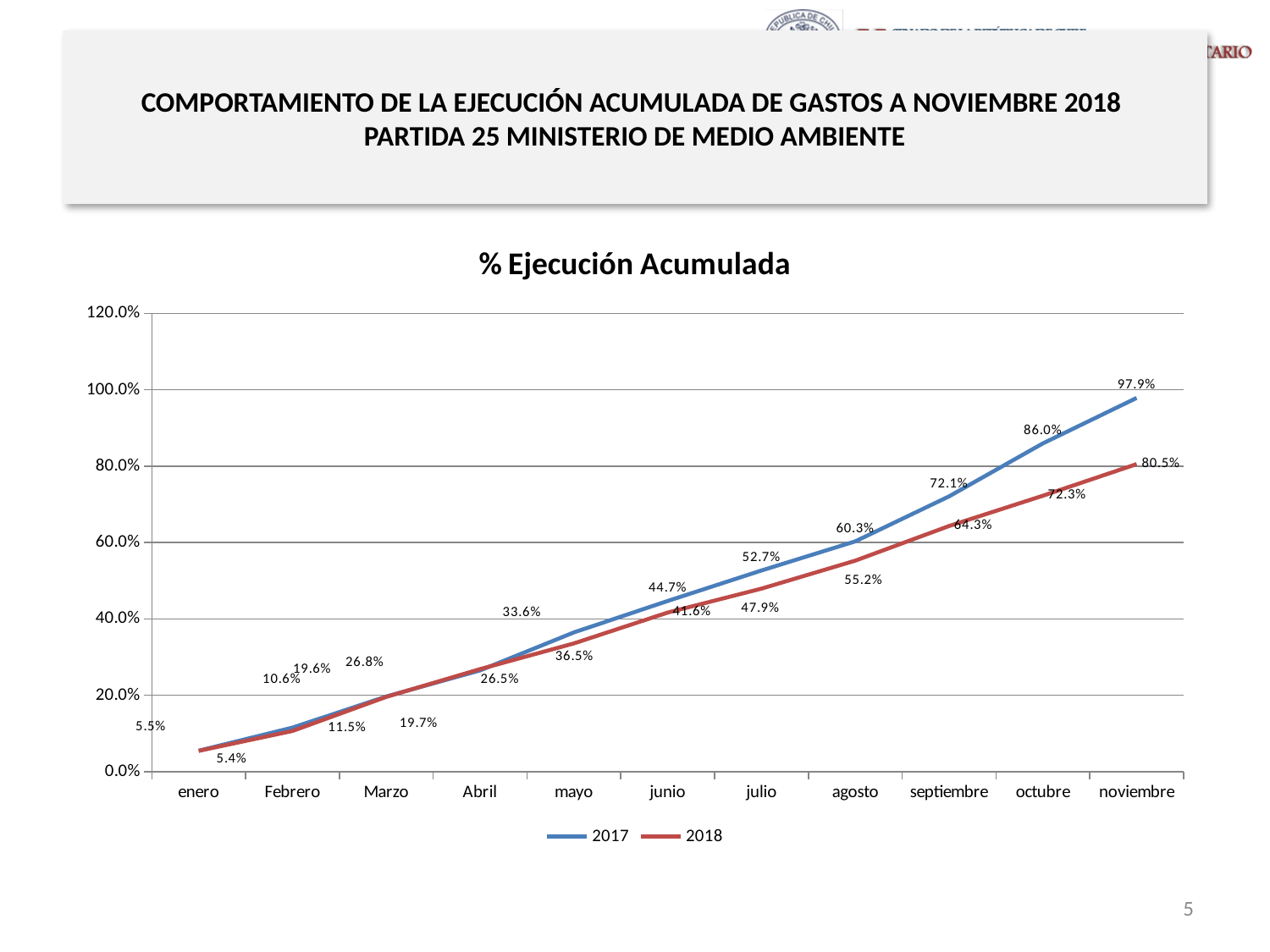
What is the value for 2018 in enero? 5.4% What is the value for 2017 in octubre? 86.0% What is the value for 2017 in noviembre? 97.9% What kind of chart is shown on the slide? Line chart In noviembre, which series has the higher value, 2017 or 2018? 2017 How many series does the legend list? 2 Do the values for 2018 rise or fall from enero to noviembre? Rise What is the value for 2017 in enero? 5.5% What is the difference between the 2017 and 2018 values in noviembre? 17.4 percentage points What is the value for 2018 in noviembre? 80.5% How many months are plotted along the x axis? 11 What is the title of the chart? % Ejecución Acumulada